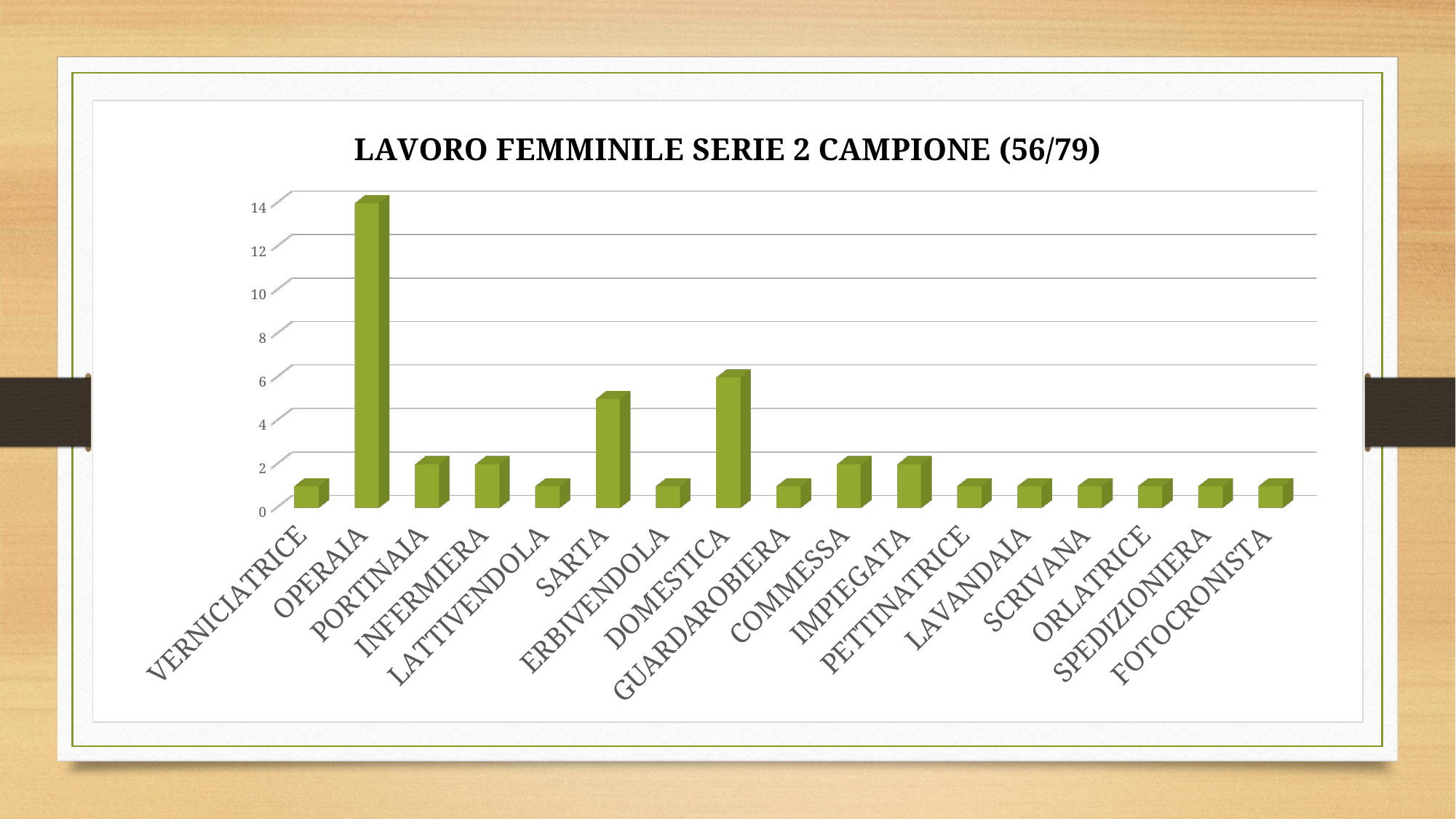
Which is larger, the value for DOMESTICA or the value for SARTA? DOMESTICA What is the value for DOMESTICA? 6 What is the value for PORTINAIA? 2 Which category has the highest value? OPERAIA How many categories are shown on the x axis? 17 What kind of chart is shown on the slide? bar chart Which is larger, the value for OPERAIA or the value for DOMESTICA? OPERAIA What is the difference between the values for OPERAIA and DOMESTICA? 8 What is the title of the chart? LAVORO FEMMINILE SERIE 2 CAMPIONE (56/79) What is the value for OPERAIA? 14 Is the value for VERNICIATRICE greater or less than 2? less Is the value for SARTA greater or less than 4? greater